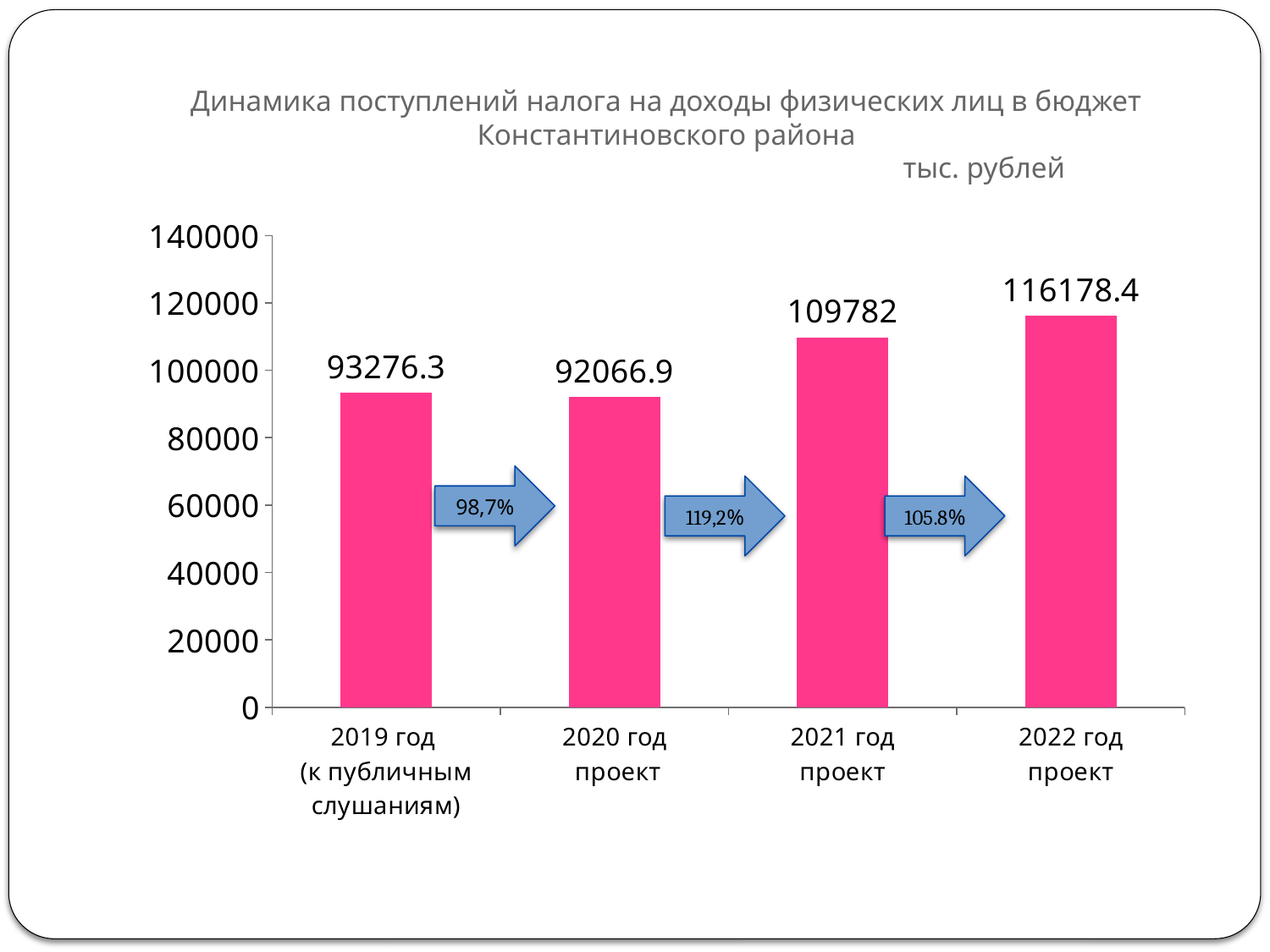
What is the value for 2022 год проект? 116178.4 What kind of chart is shown on the slide? bar chart What is the value for 2019 год (к публичным слушаниям)? 93276.3 Which year has the highest value? 2022 год проект What is the value for 2021 год проект? 109782 How many bars are shown in the chart? 4 What is the value for 2020 год проект? 92066.9 Which is larger, the value for 2019 год or the value for 2020 год? 2019 год Is the value for 2021 год проект greater or less than 100000? greater What is the difference between the values for 2022 год проект and 2021 год проект? 6396.4 Which year has the lowest value? 2020 год проект What is the difference between the values for 2021 год проект and 2020 год проект? 17715.1